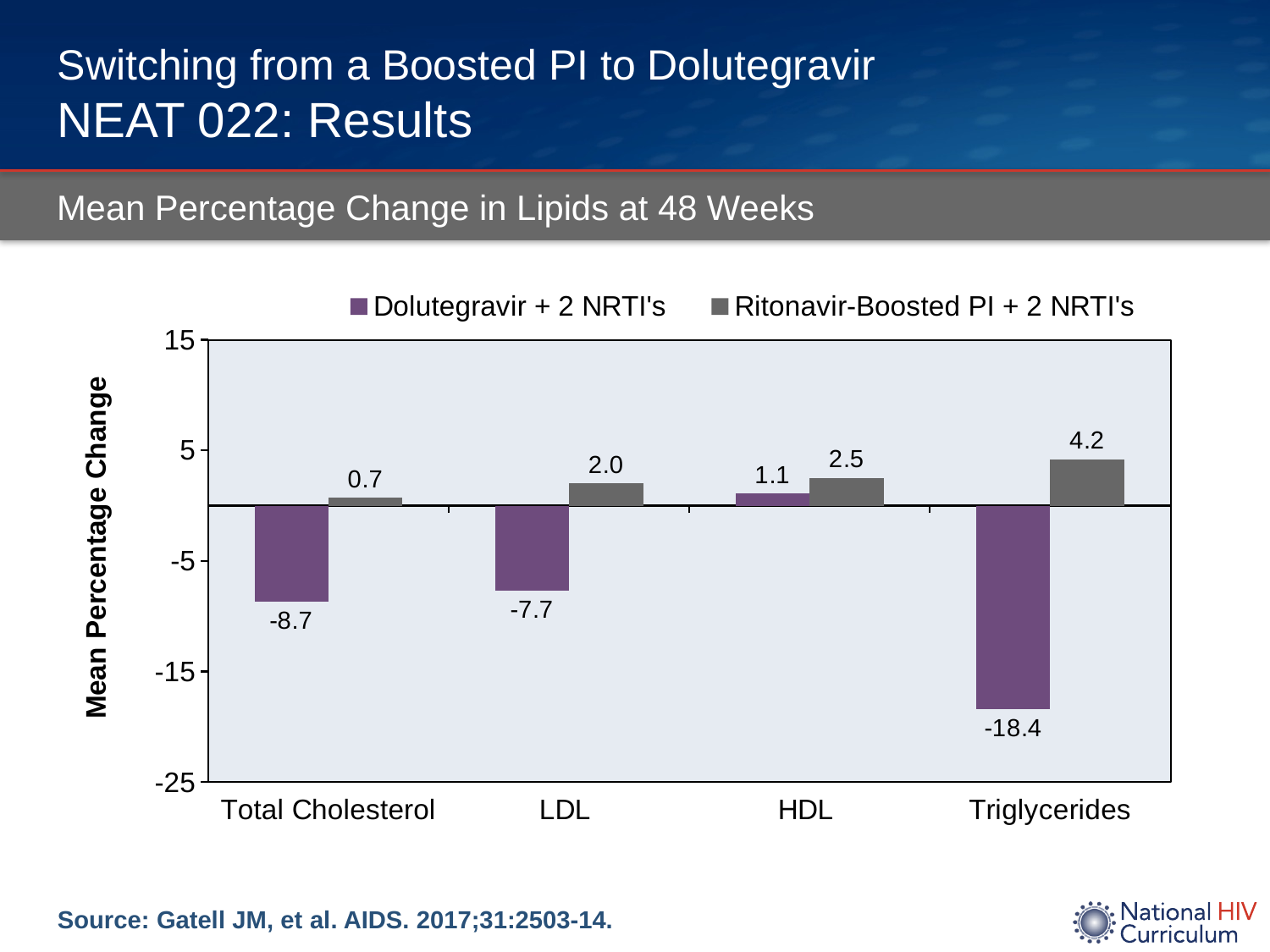
Which lipid category has the lowest value for Dolutegravir + 2 NRTI's? Triglycerides For LDL, which series has the larger value: Dolutegravir + 2 NRTI's or Ritonavir-Boosted PI + 2 NRTI's? Ritonavir-Boosted PI + 2 NRTI's What is the mean percentage change in Triglycerides for Ritonavir-Boosted PI + 2 NRTI's? 4.2 How many lipid categories are shown on the x axis? 4 What is the mean percentage change in LDL for Ritonavir-Boosted PI + 2 NRTI's? 2.0 What is the difference between the Ritonavir-Boosted PI + 2 NRTI's and Dolutegravir + 2 NRTI's values for HDL? 1.4 What is the mean percentage change in HDL for Dolutegravir + 2 NRTI's? 1.1 What is the mean percentage change in Total Cholesterol for Dolutegravir + 2 NRTI's? -8.7 What kind of chart is shown on the slide? Bar chart What is the difference between the Ritonavir-Boosted PI + 2 NRTI's and Dolutegravir + 2 NRTI's values for Triglycerides? 22.6 How many series does the legend list? 2 Which lipid category has the highest value for Ritonavir-Boosted PI + 2 NRTI's? Triglycerides